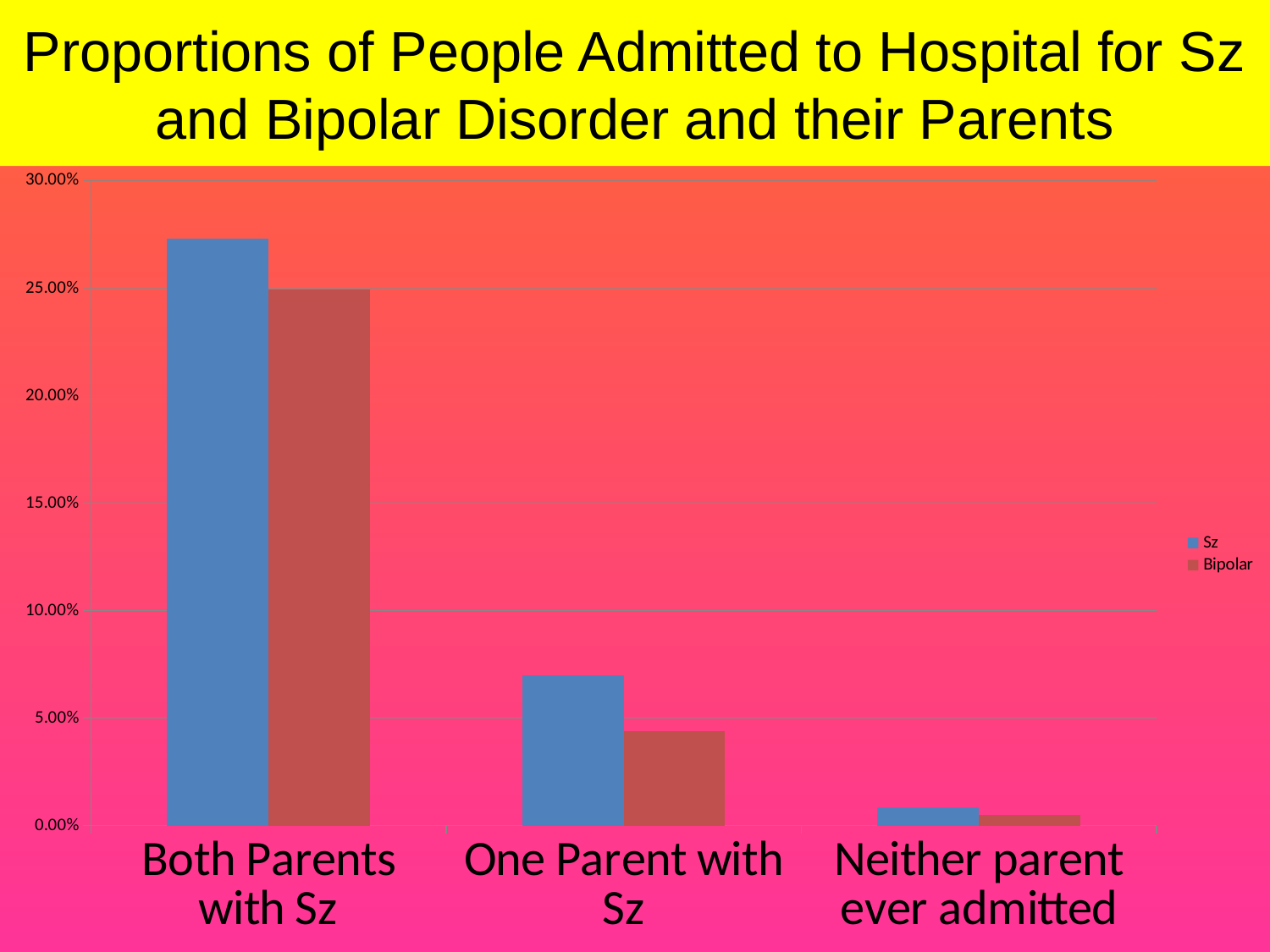
Is the Bipolar value for Both Parents with Sz greater or less than 20.00%? greater Do the Sz values rise or fall moving from left to right across the categories? fall Is the Bipolar value for One Parent with Sz greater or less than 5.00%? less How many categories are shown on the x axis? 3 What kind of chart is shown on the slide? bar chart Which category has the highest value for the Sz series? Both Parents with Sz Is the Sz value for One Parent with Sz greater or less than 5.00%? greater How many series does the legend list? 2 Which series is shown in blue? Sz Which category has the lowest value for the Bipolar series? Neither parent ever admitted For Both Parents with Sz, which series has the larger value, Sz or Bipolar? Sz